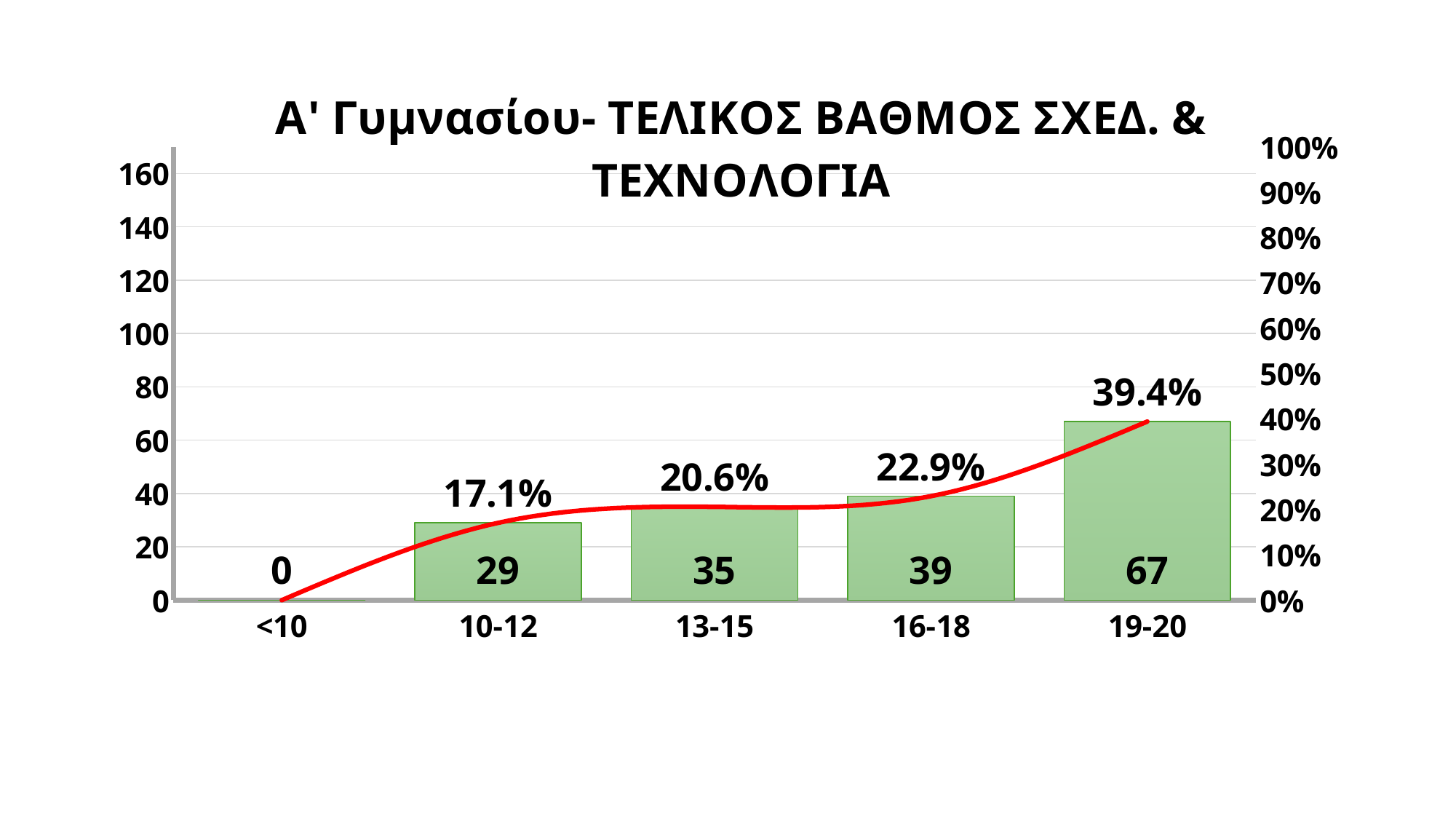
What is the total number of students across all grade bands? 170 Do the bar values rise or fall from left to right along the x axis? rise Which grade band has the highest number of students? 19-20 Which grade band has more students, 13-15 or 10-12? 13-15 What colour is the line plotted over the bars? red How many grade bands are shown on the x axis? 5 What percentage is shown for the 13-15 grade band? 20.6% What is the number of students in the 19-20 grade band? 67 What is the difference in the number of students between the 19-20 and 16-18 grade bands? 28 What percentage is shown for the 16-18 grade band? 22.9% Which grade band has the lowest number of students? <10 What is the number of students in the 10-12 grade band? 29